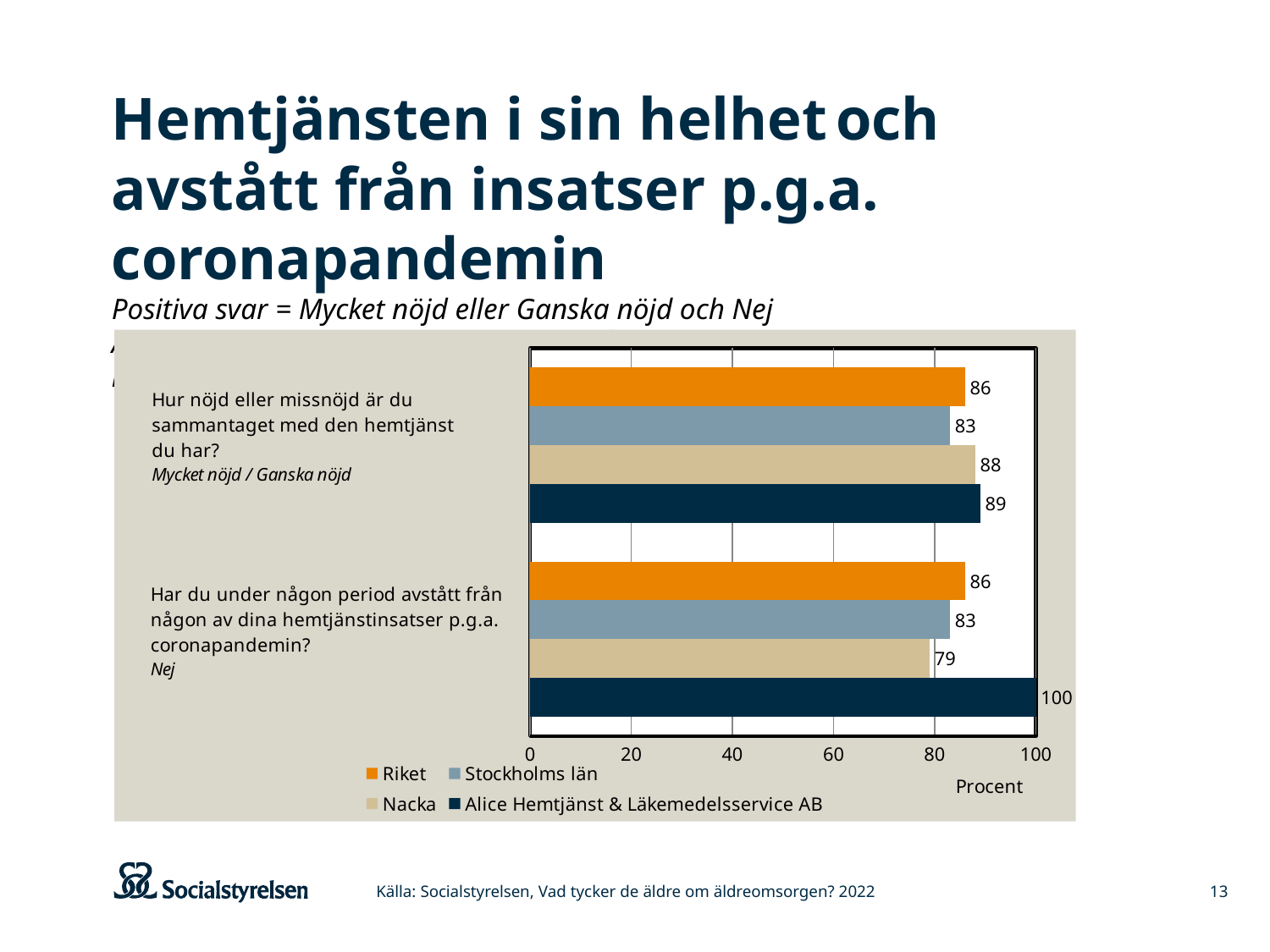
Which series has the highest value on the question about having refrained from home care services due to the coronapandemic? Alice Hemtjänst & Läkemedelsservice AB How many question categories are shown in the chart? 2 Which series has the lowest value on the question "Hur nöjd eller missnöjd är du sammantaget med den hemtjänst du har?"? Stockholms län What is the value for Riket on the question "Hur nöjd eller missnöjd är du sammantaget med den hemtjänst du har?"? 86 How many series does the legend list? 4 Which is larger on the question "Hur nöjd eller missnöjd är du sammantaget med den hemtjänst du har?": Nacka or Riket? Nacka What is the value for Nacka on the question "Har du under någon period avstått från någon av dina hemtjänstinsatser p.g.a. coronapandemin?"? 79 What is the value for Alice Hemtjänst & Läkemedelsservice AB on the question about having refrained from home care services due to the coronapandemic? 100 What is the label on the horizontal axis of the chart? Procent What is the value for Stockholms län on the question "Hur nöjd eller missnöjd är du sammantaget med den hemtjänst du har?"? 83 What is the difference between Alice Hemtjänst & Läkemedelsservice AB and Nacka on the question about having refrained from home care services due to the coronapandemic? 21 What kind of chart is shown on the slide? Bar chart